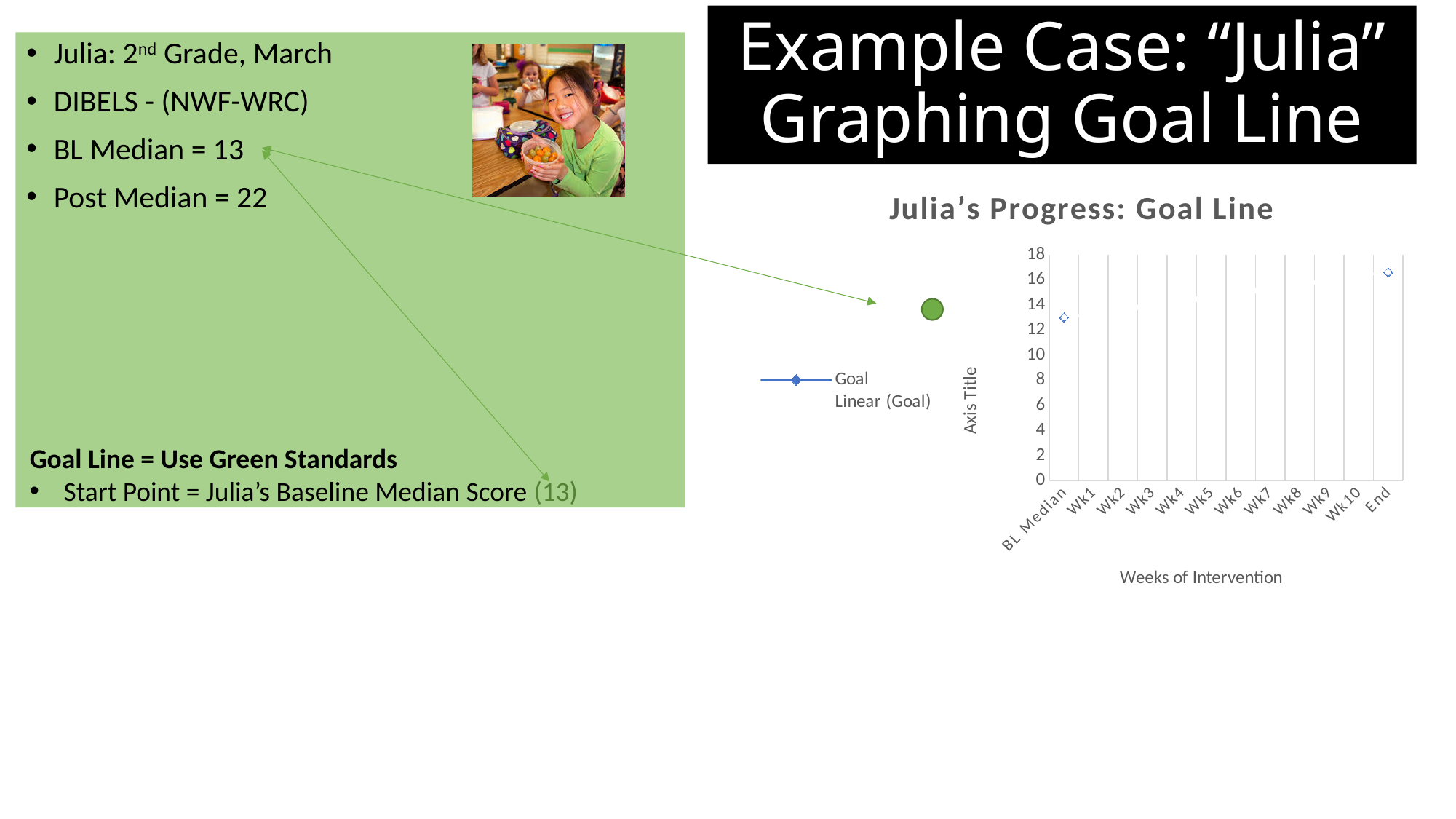
Is the value plotted for End greater or less than 18? less What is the title of the horizontal axis of the chart? Weeks of Intervention Is the value plotted for End greater or less than 16? greater Which category has the highest plotted value? End What kind of chart is shown on the slide? line chart Is the value plotted for BL Median greater or less than 14? less How many entries does the chart's legend list? 2 What is the title of the chart? Julia's Progress: Goal Line Do the plotted values rise or fall from BL Median to End? rise How many categories are shown along the x axis of the chart? 12 Which plotted point is higher, BL Median or End? End